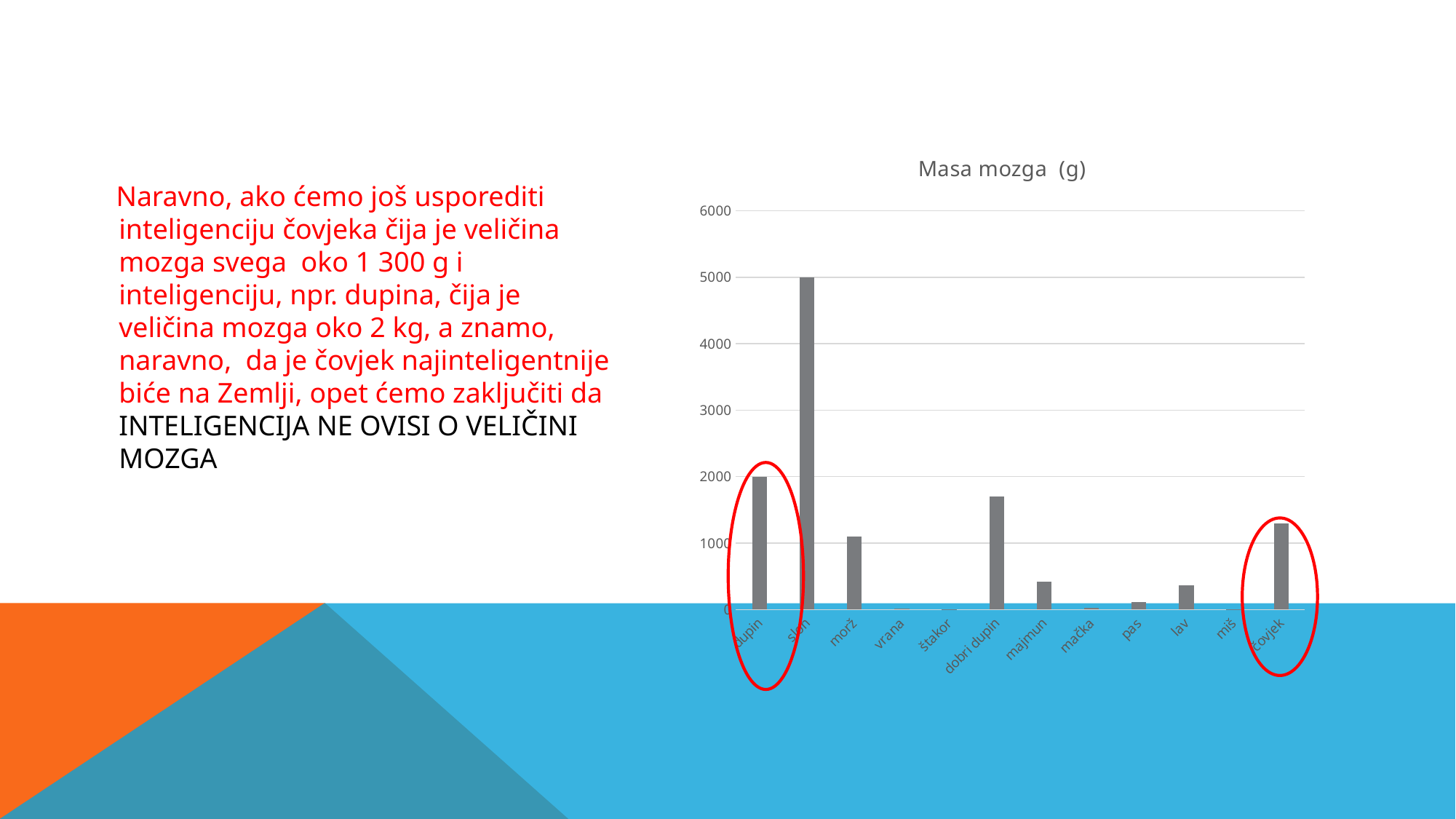
What is the value for dupin? 2000 What is the value for slon? 5000 Is the value for dobri dupin greater or less than 2000? less Which is larger, the value for dobri dupin or the value for morž? dobri dupin Is the value for čovjek greater or less than 1000? greater Is the value for majmun greater or less than 1000? less Which is larger, the value for dupin or the value for čovjek? dupin Which category has the highest value in the chart? slon How many categories are shown on the x axis of the chart? 12 What kind of chart is shown on the slide? bar chart What is the title of the chart? Masa mozga (g) Which is larger, the value for morž or the value for majmun? morž